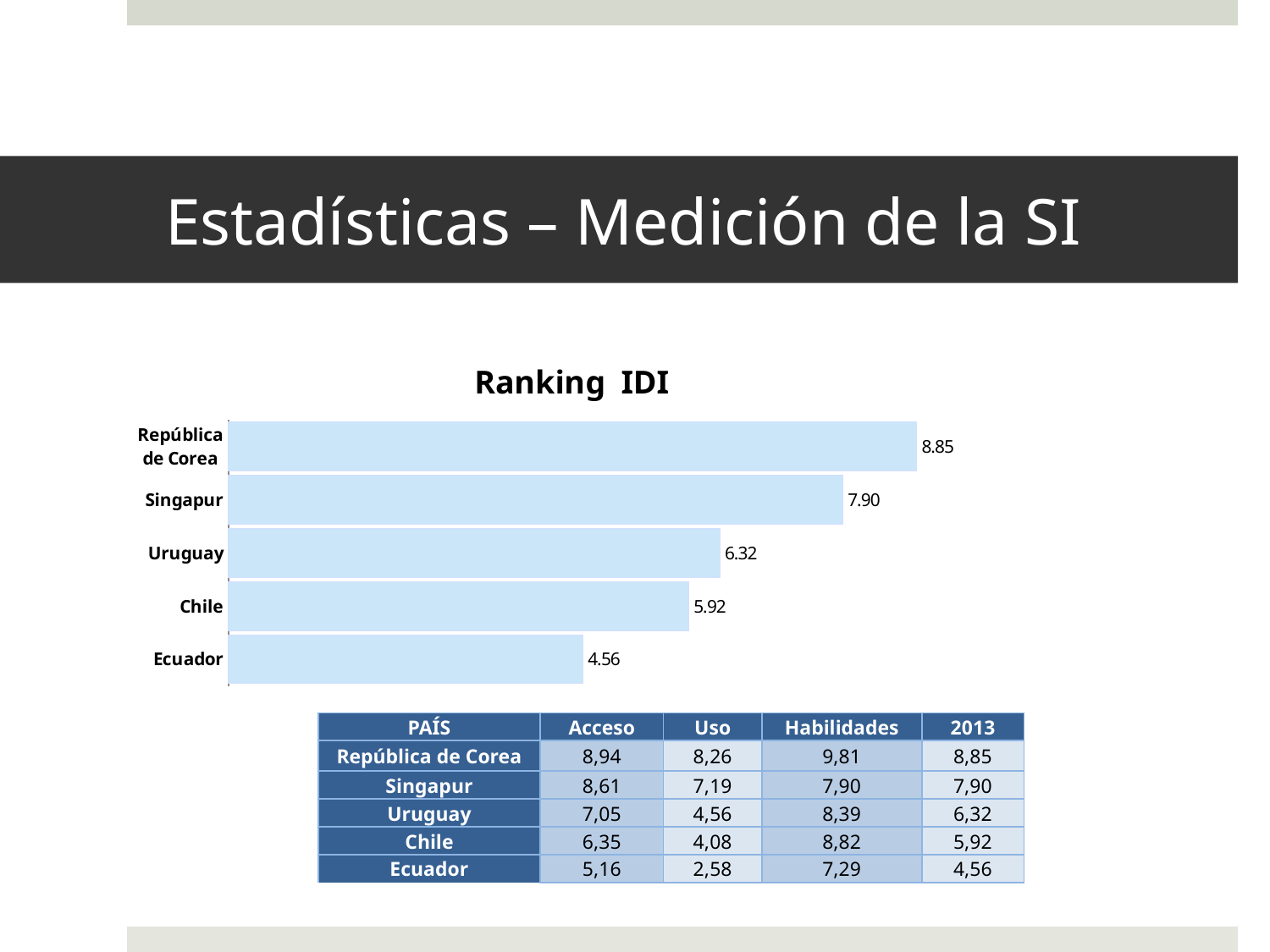
What is the value for Uruguay in the Ranking IDI chart? 6.32 How many countries are shown in the Ranking IDI chart? 5 Which country has the highest value in the Ranking IDI chart? República de Corea Which has a larger value in the Ranking IDI chart, Singapur or Uruguay? Singapur What is the value for Chile in the Ranking IDI chart? 5.92 What is the value for Ecuador in the Ranking IDI chart? 4.56 What is the difference between the values for República de Corea and Singapur in the Ranking IDI chart? 0.95 Which country has the lowest value in the Ranking IDI chart? Ecuador What is the value for Singapur in the Ranking IDI chart? 7.90 What is the value for República de Corea in the Ranking IDI chart? 8.85 What type of chart is the Ranking IDI chart? Bar chart What is the difference between the values for Uruguay and Chile in the Ranking IDI chart? 0.40